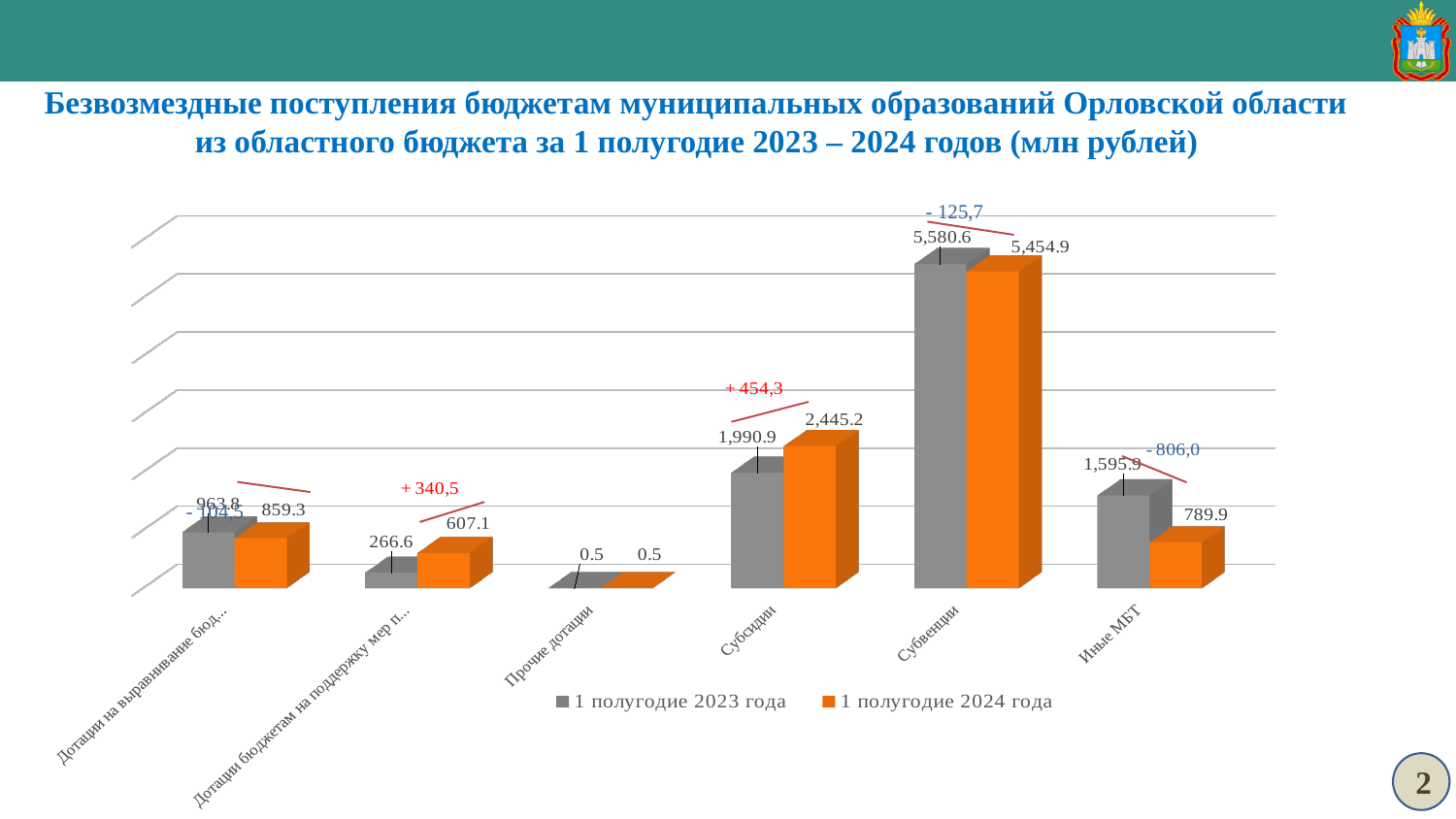
What is the value for Субсидии in the series 1 полугодие 2024 года? 2,445.2 Which category has the lowest value in the series 1 полугодие 2024 года? Прочие дотации For Иные МБТ, which series has the larger value: 1 полугодие 2023 года or 1 полугодие 2024 года? 1 полугодие 2023 года What is the value for Иные МБТ in the series 1 полугодие 2024 года? 789.9 How many series does the legend list? 2 What is the difference between the 2023 and 2024 values for Субвенции? 125.7 What is the difference between the 2024 and 2023 values for Субсидии? 454.3 Which category has the highest value in the series 1 полугодие 2023 года? Субвенции What kind of chart is shown on the slide? Bar chart How many categories are shown on the x axis of the chart? 6 What is the value for Прочие дотации in the series 1 полугодие 2023 года? 0.5 What is the value for Субвенции in the series 1 полугодие 2023 года? 5,580.6